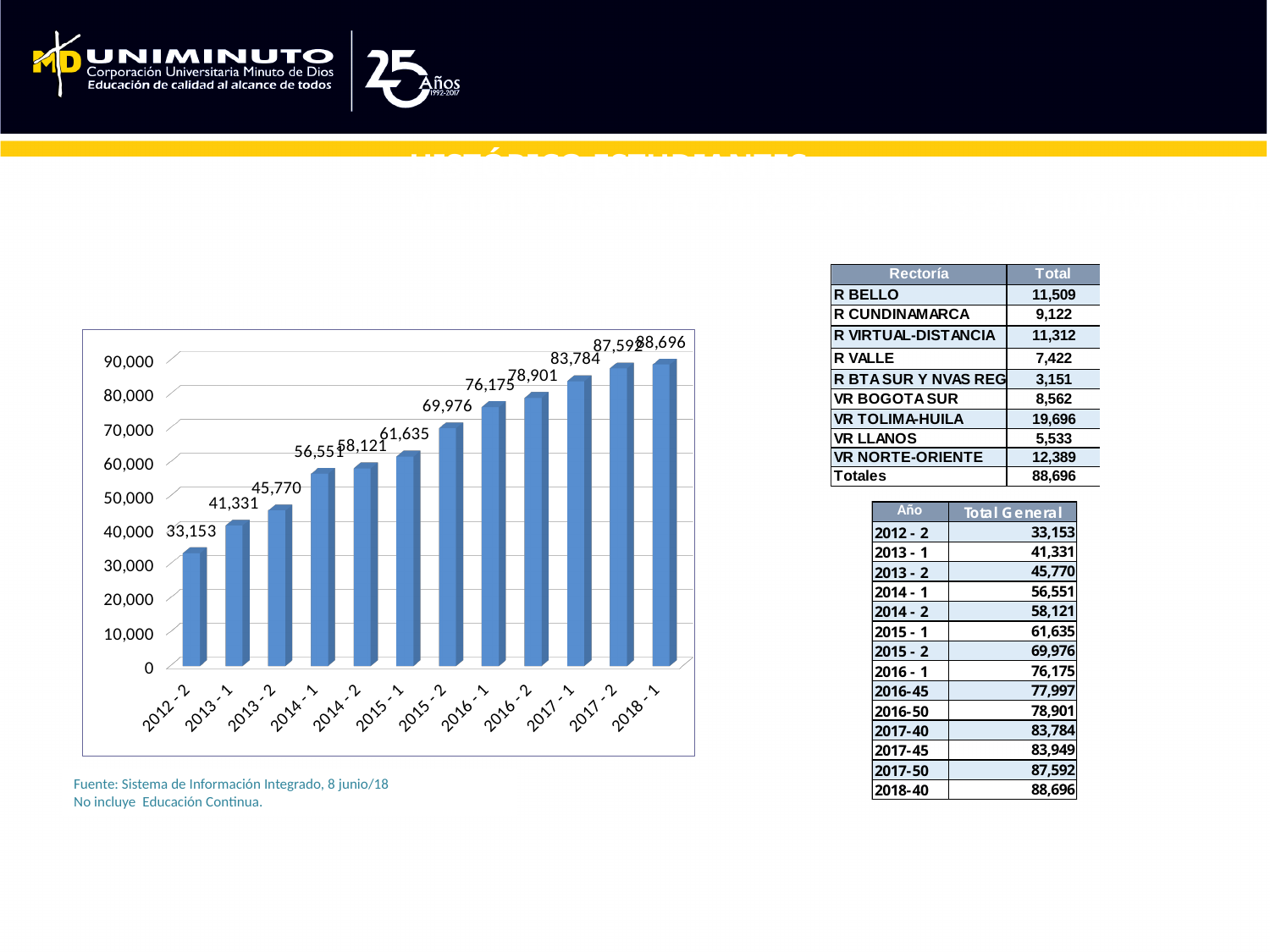
Do the values in the chart rise or fall from 2012 - 2 to 2018 - 1? rise What is the difference between the values for 2014 - 1 and 2013 - 2? 10,781 What is the value shown for 2018 - 1 in the chart? 88,696 What is the difference between the values for 2018 - 1 and 2012 - 2? 55,543 Which period has the highest value in the chart? 2018 - 1 How many bars (periods) are plotted in the chart? 12 Is the value for 2017 - 1 greater or less than 80,000? greater What is the value shown for 2015 - 2 in the chart? 69,976 What type of chart is shown on the slide? bar chart Which period has the lowest value in the chart? 2012 - 2 What is the value shown for 2012 - 2 in the chart? 33,153 Which is larger, the value for 2016 - 1 or the value for 2015 - 1? 2016 - 1